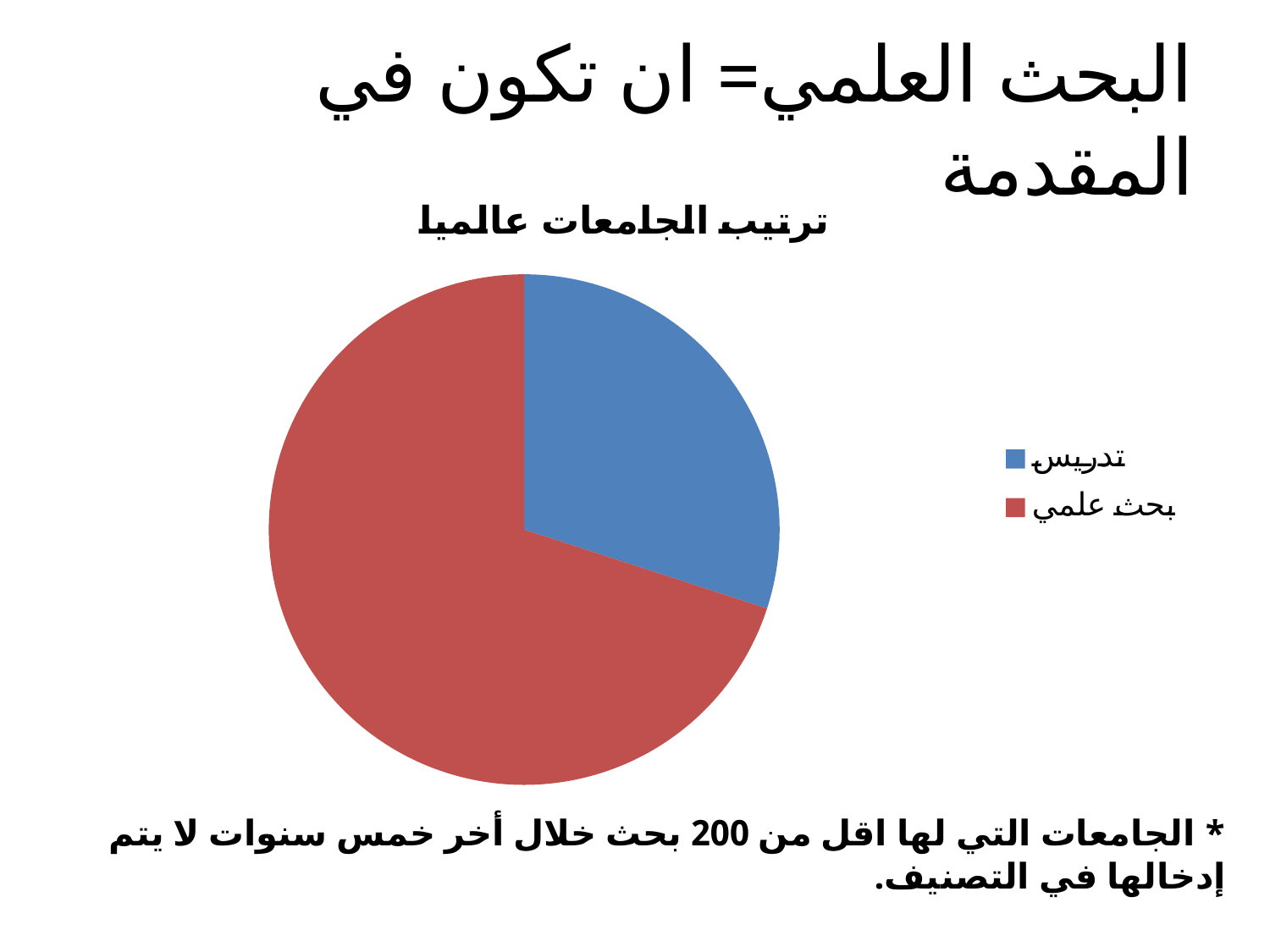
What is the title of the pie chart? ترتيب الجامعات عالميا What kind of chart is shown on the slide? pie chart What colour is the slice for تدريس in the pie chart? blue Does the slice for تدريس take up more or less than half of the pie? less Which category has the smallest slice of the pie chart? تدريس How many entries does the legend of the pie chart list? 2 Does the slice for بحث علمي take up more or less than half of the pie? more Which category has the largest slice of the pie chart? بحث علمي Which slice is larger, تدريس or بحث علمي? بحث علمي How many slices does the pie chart have? 2